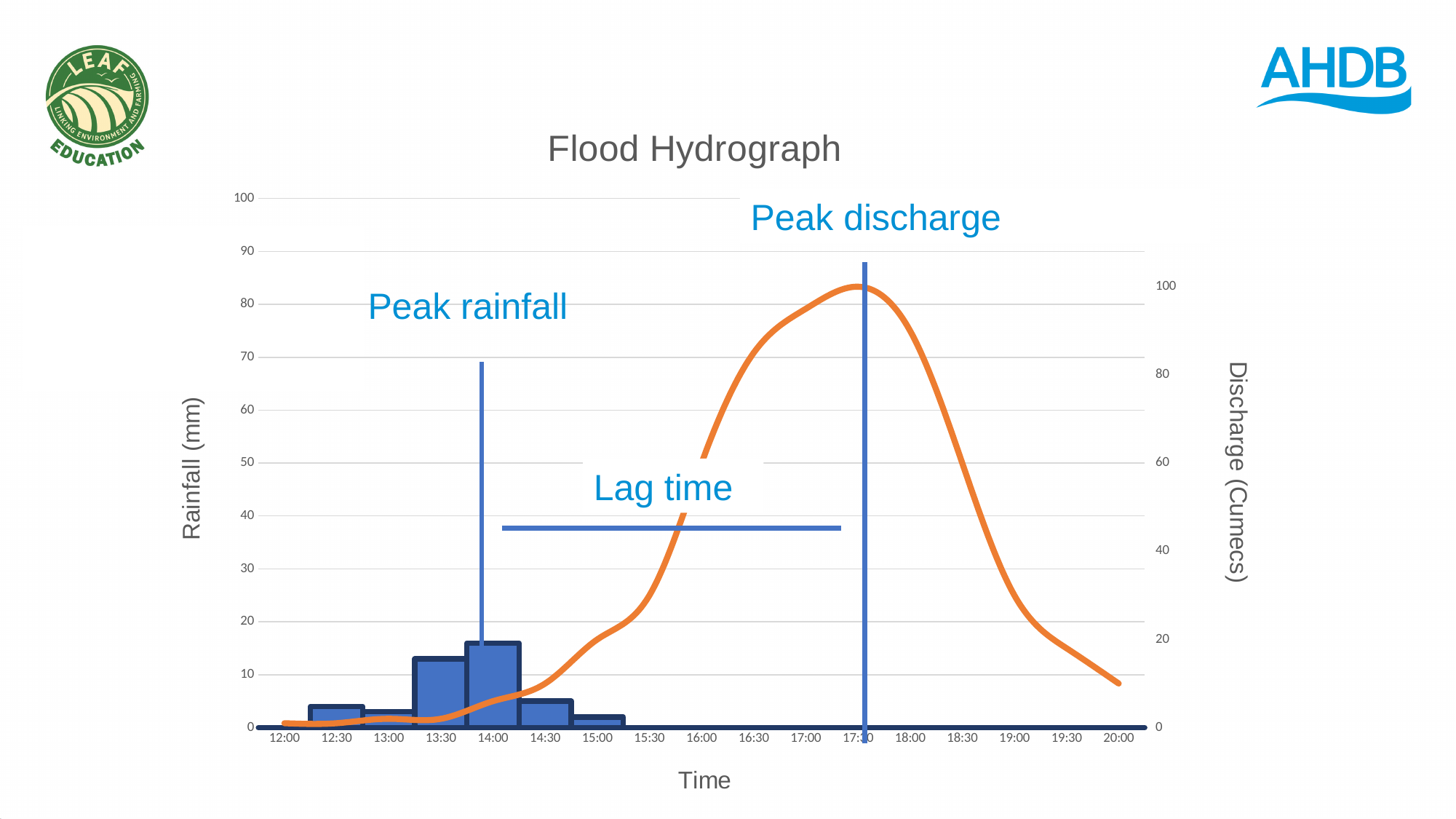
What kind of chart is shown on the slide? Combined bar and line chart Is the rainfall value for 14:00 greater or less than 10? greater Is the rainfall value for 12:30 greater or less than 10? less Which has the larger rainfall bar, 13:30 or 14:30? 13:30 At which time is the rainfall bar lowest? 15:00 Is the discharge value at 20:00 greater or less than 20 cumecs? less At which time is the rainfall bar highest? 14:00 How does the discharge line change between 17:30 and 20:00? It falls What is the title of the chart? Flood Hydrograph At what time does the chart mark the peak discharge? 17:30 How many rainfall bars are plotted on the chart? 6